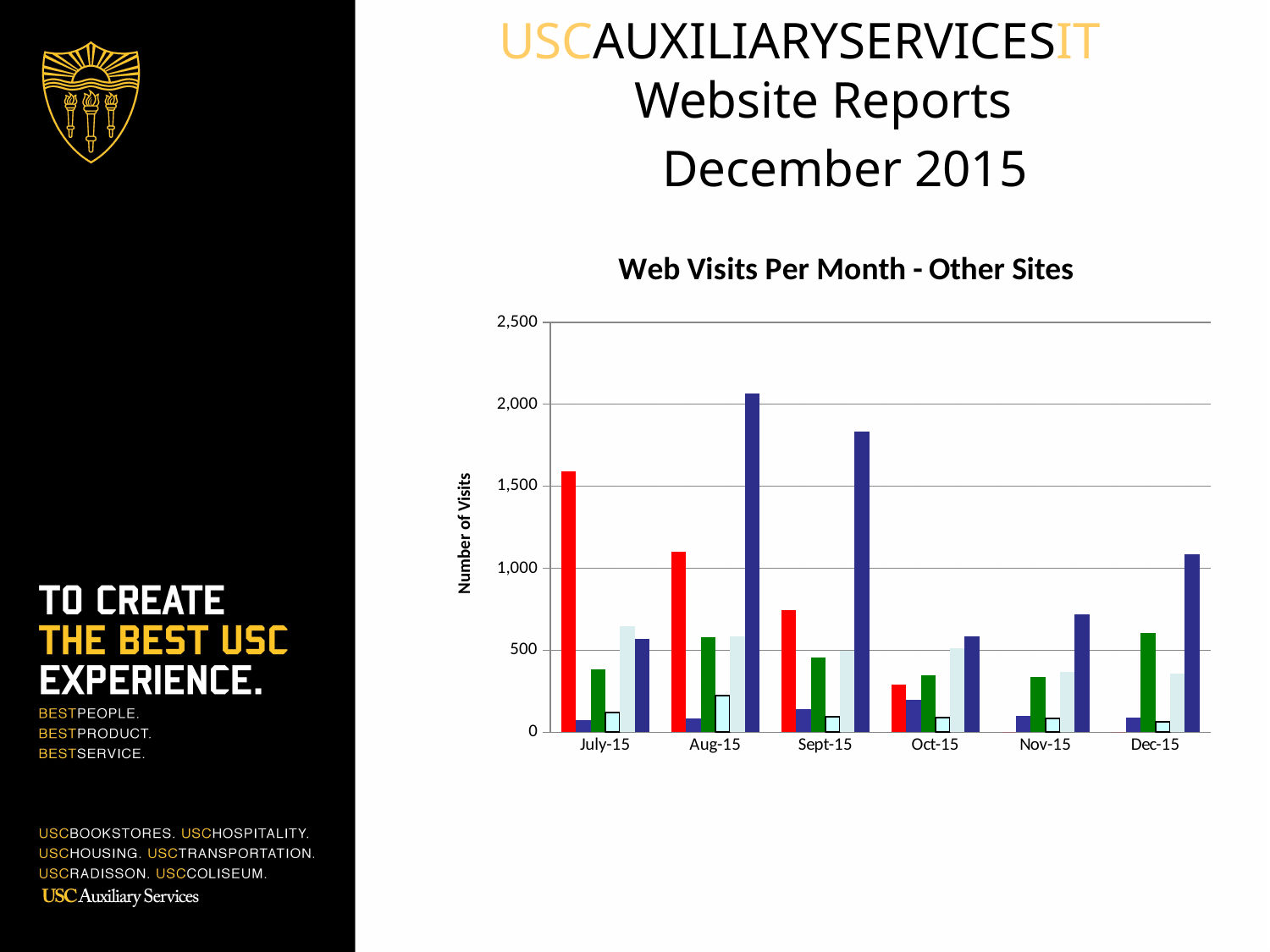
Is the value of the red bar for July-15 greater or less than 1,500? greater Is the value of the tallest bar for Sept-15 greater or less than 2,000? less What kind of chart is shown on the slide? Bar chart Do the red bars rise or fall from July-15 to Oct-15? fall What is the label on the vertical axis of the chart? Number of Visits Is the value of the red bar for Oct-15 greater or less than 500? less Which month contains the tallest bar in the chart? Aug-15 How many months are shown along the x axis of the chart? 6 In which month is the red bar the tallest? July-15 What is the title of the chart? Web Visits Per Month - Other Sites